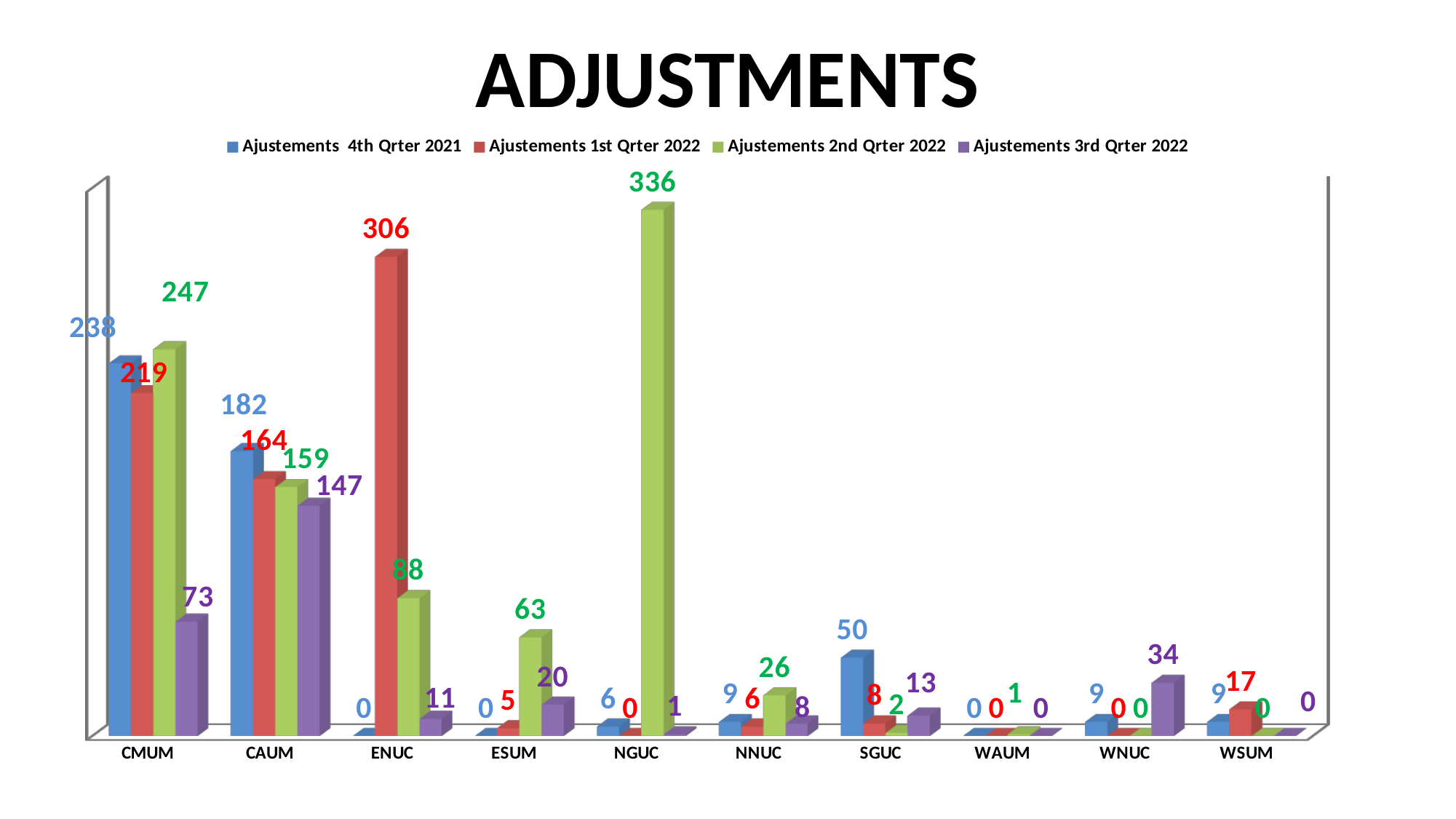
What is the total of the four series values for WNUC? 43 How many series does the legend list? 4 What is the value for CMUM in the Ajustements 3rd Qrter 2022 series? 73 What is the title of the chart? ADJUSTMENTS What is the difference between the Ajustements 2nd Qrter 2022 value for NGUC and the Ajustements 1st Qrter 2022 value for ENUC? 30 What is the value for SGUC in the Ajustements 4th Qrter 2021 series? 50 For CAUM, which is larger: the Ajustements 4th Qrter 2021 value or the Ajustements 3rd Qrter 2022 value? Ajustements 4th Qrter 2021 How many categories are shown on the x axis? 10 Which category has the highest value in the Ajustements 2nd Qrter 2022 series? NGUC What is the value for ENUC in the Ajustements 1st Qrter 2022 series? 306 What kind of chart is shown on the slide? Bar chart Which category has the lowest value in the Ajustements 4th Qrter 2021 series? ENUC, ESUM and WAUM (all 0)